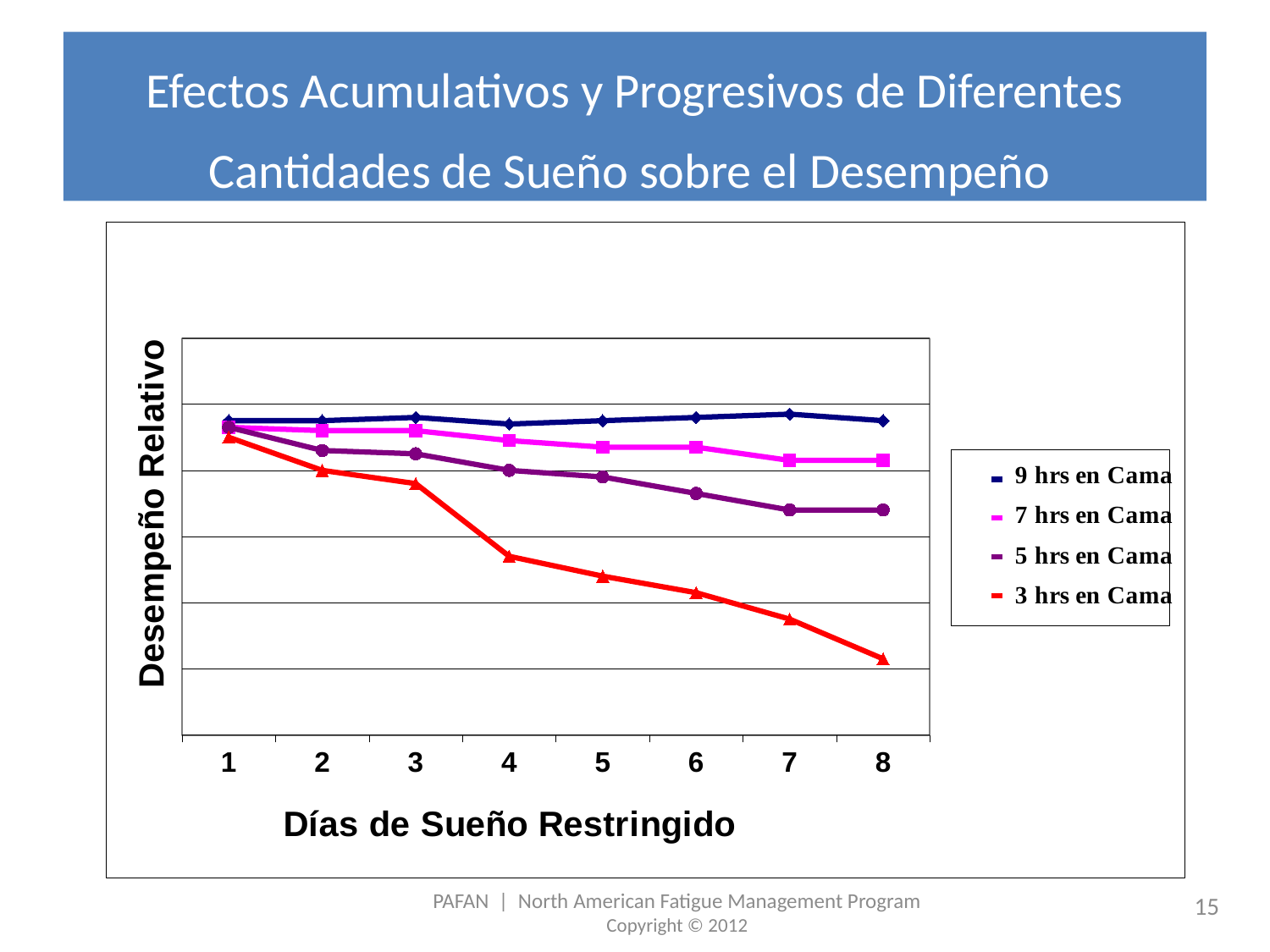
Which series has the highest relative performance on day 8? 9 hrs en Cama What kind of chart is shown on the slide? line chart On day 6, which series shows higher relative performance: 5 hrs en Cama or 3 hrs en Cama? 5 hrs en Cama Does the line for 3 hrs en Cama rise or fall as the days of restricted sleep increase? fall How many days are shown along the x axis of the chart? 8 Which series has the lowest relative performance on day 8? 3 hrs en Cama How many series does the legend list? 4 Which series shows the steepest decline over the 8 days? 3 hrs en Cama On day 8, which series shows higher relative performance: 7 hrs en Cama or 5 hrs en Cama? 7 hrs en Cama What is the title of the x axis of the chart? Días de Sueño Restringido What is the title of the y axis of the chart? Desempeño Relativo